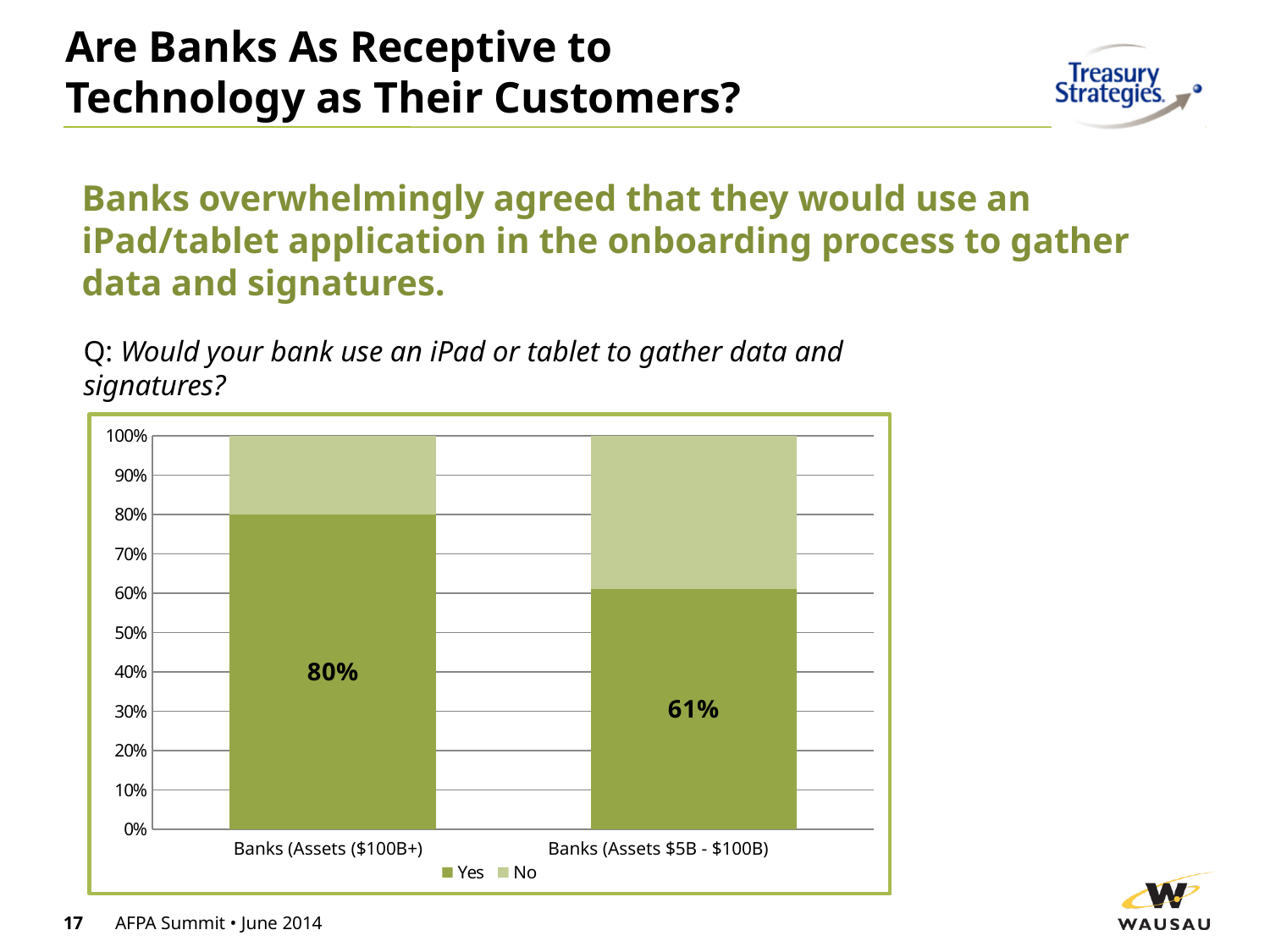
How many bank categories are shown on the x axis? 2 What kind of chart is shown on the slide? Stacked bar chart Is the No share for banks with assets of $5B - $100B greater or less than 30%? greater Is the No share for banks with assets of $100B+ greater or less than 30%? less What is the difference between the Yes percentages for the two bank categories? 19% Which bank category has the higher Yes percentage? Banks (Assets ($100B+) How many series does the legend list? 2 Is the Yes share larger for banks with assets of $100B+ or for banks with assets of $5B - $100B? Banks (Assets ($100B+) What percentage of banks with assets of $5B - $100B answered Yes? 61% What percentage of banks with assets of $100B+ answered Yes? 80% Which bank category has the lower Yes percentage? Banks (Assets $5B - $100B) What are the two entries in the chart legend? Yes and No